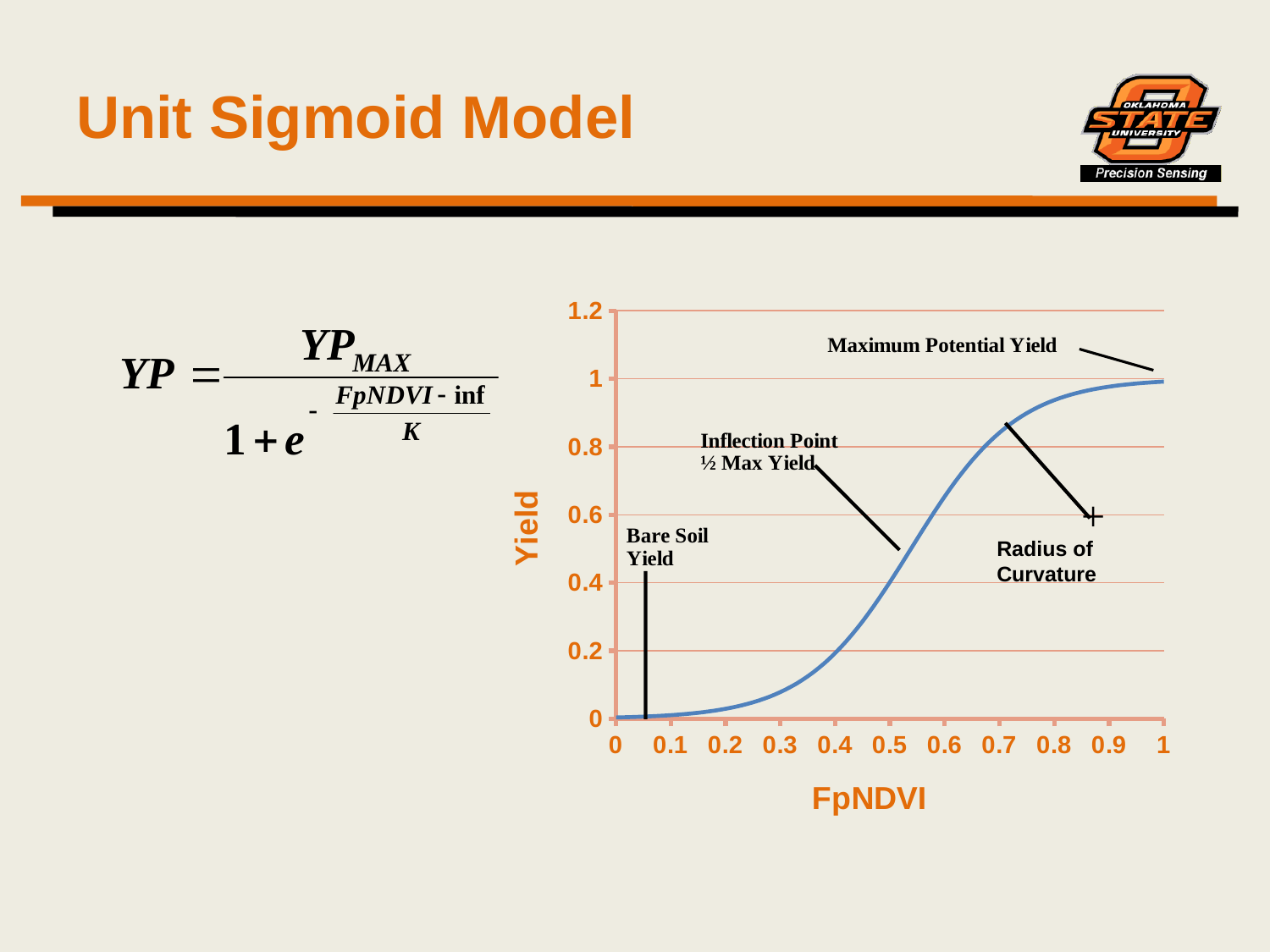
Is the Yield value at FpNDVI 0.2 greater or less than 0.2? less Is the Yield value at FpNDVI 0.3 greater or less than 0.2? less Which of the two FpNDVI values, 0.4 or 0.8, has the larger Yield? 0.8 What is the label of the x axis of the chart? FpNDVI Is the Yield value at FpNDVI 0.9 greater or less than 0.8? greater What kind of chart is shown on the slide? line chart Does Yield rise or fall as FpNDVI increases along the x axis? rise What is the label of the y axis of the chart? Yield